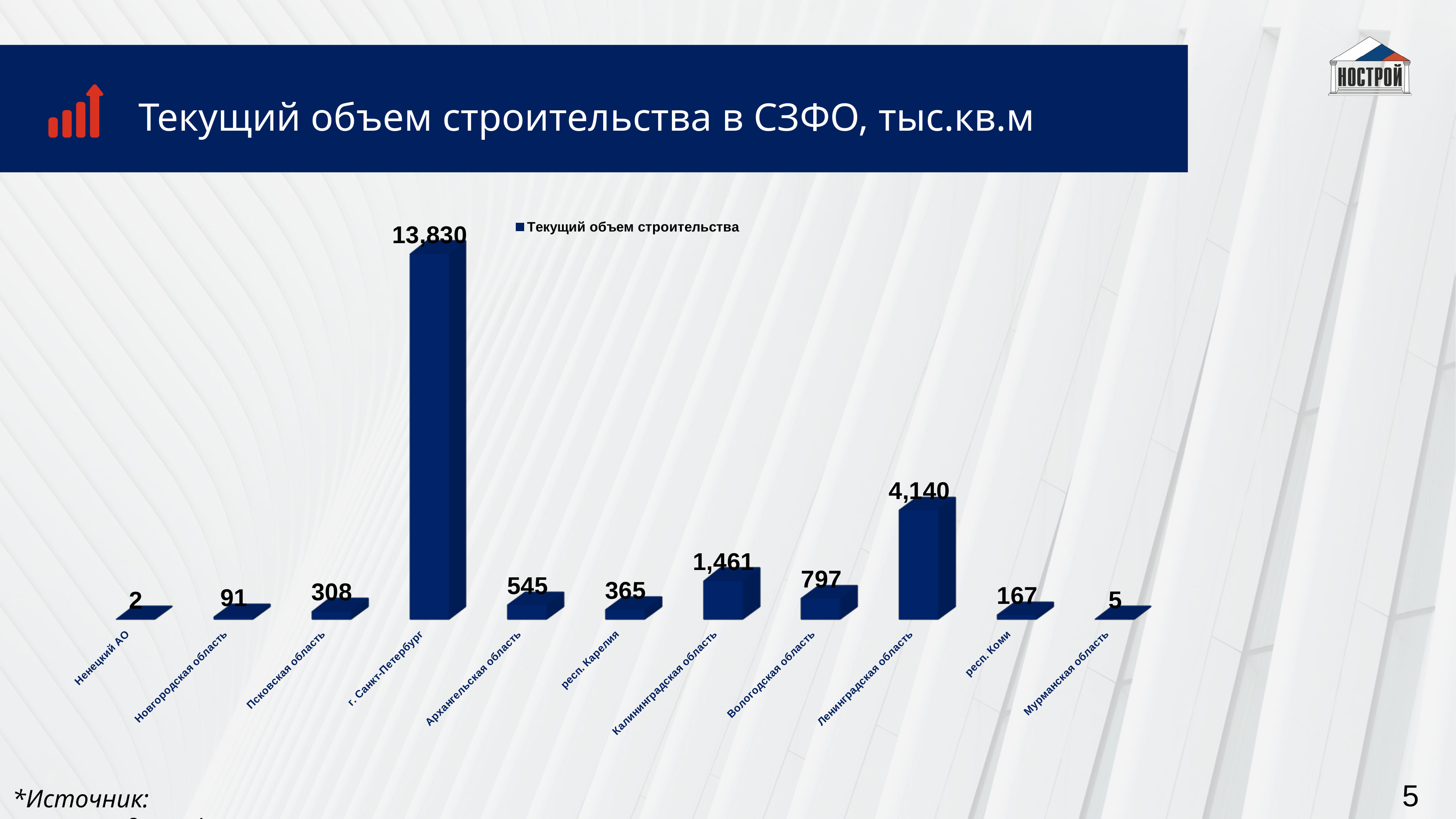
What is the value for Ленинградская область? 4,140 What is the value for Калининградская область? 1,461 Which category has the lowest value? Ненецкий АО What kind of chart is shown on the slide? bar chart What is the difference between the values for Вологодская область and Архангельская область? 252 What is the legend entry of the chart? Текущий объем строительства How many categories are shown on the chart? 11 How many series does the legend list? 1 Which category has the highest value? г. Санкт-Петербург What is the value for г. Санкт-Петербург? 13,830 What is the value for респ. Коми? 167 Which is larger, the value for Псковская область or the value for респ. Карелия? респ. Карелия